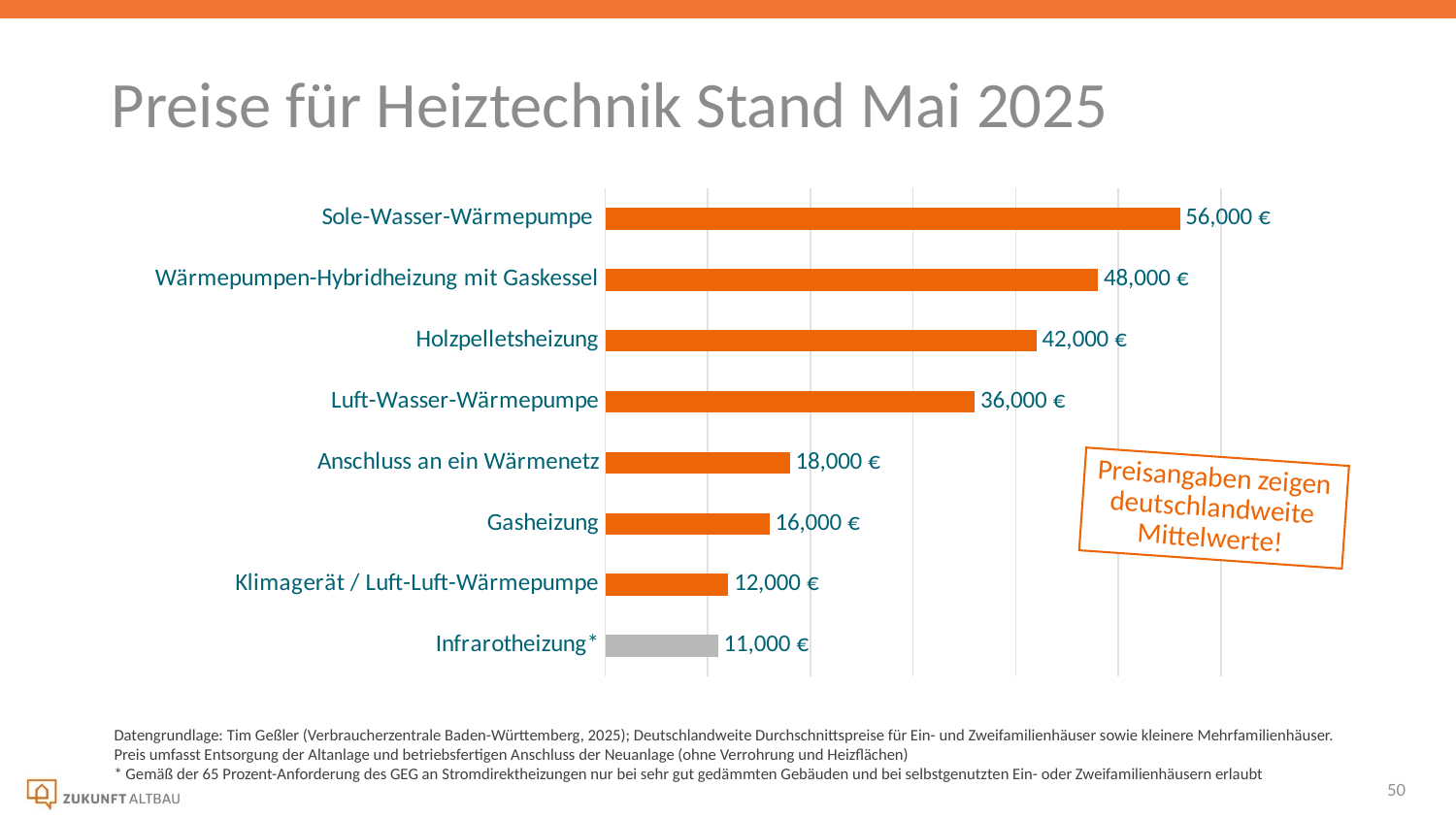
What is the title of the slide? Preise für Heiztechnik Stand Mai 2025 What is the price shown for Gasheizung? 16,000 € What is the price shown for Sole-Wasser-Wärmepumpe? 56,000 € What is the difference in price between Wärmepumpen-Hybridheizung mit Gaskessel and Holzpelletsheizung? 6,000 € What is the price shown for Anschluss an ein Wärmenetz? 18,000 € Which is more expensive, Gasheizung or Klimagerät / Luft-Luft-Wärmepumpe? Gasheizung How many heating technologies are shown in the chart? 8 What type of chart is shown on the slide? Bar chart Which heating technology has the highest price in the chart? Sole-Wasser-Wärmepumpe What is the difference in price between Sole-Wasser-Wärmepumpe and Luft-Wasser-Wärmepumpe? 20,000 € Which heating technology has the lowest price in the chart? Infrarotheizung* What is the price shown for Holzpelletsheizung? 42,000 €